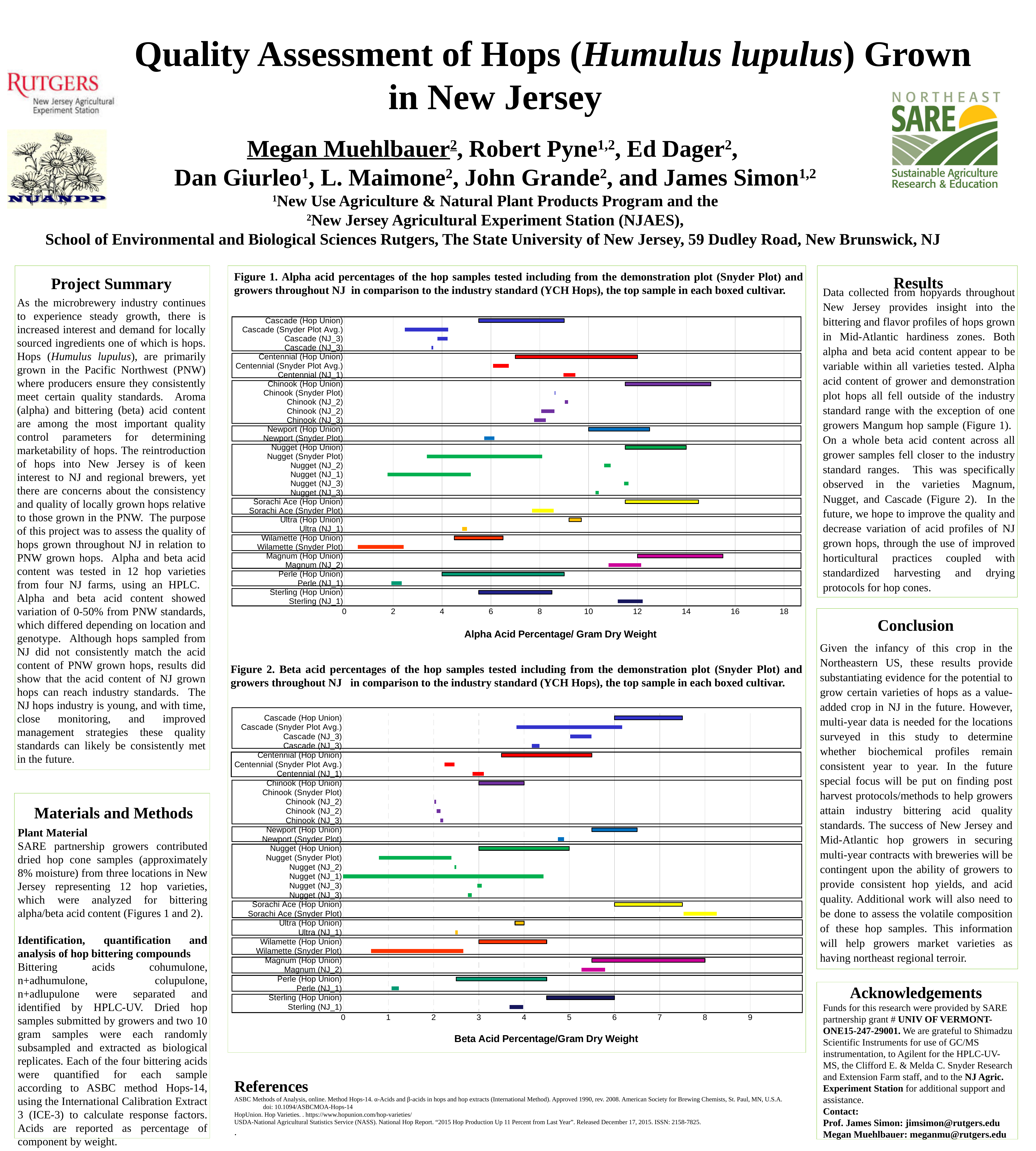
In Figure 1 (Alpha acid percentages), is the value for Sterling (NJ_1) greater or less than 10? greater In Figure 1 (Alpha acid percentages), is the value for Chinook (Hop Union) greater or less than 10? greater What kind of chart is Figure 1 (Alpha acid percentages)? bar chart In Figure 1 (Alpha acid percentages), is the value for Wilamette (Snyder Plot) greater or less than 4? less In Figure 2 (Beta acid percentages), what is the x-axis title? Beta Acid Percentage/Gram Dry Weight In Figure 1 (Alpha acid percentages), which is larger, the value for Chinook (Hop Union) or the value for Perle (NJ_1)? Chinook (Hop Union) What kind of chart is Figure 2 (Beta acid percentages)? bar chart In Figure 1 (Alpha acid percentages), what is the x-axis title? Alpha Acid Percentage/ Gram Dry Weight In Figure 2 (Beta acid percentages), which is larger, the value for Cascade (Hop Union) or the value for Chinook (NJ_2)? Cascade (Hop Union)